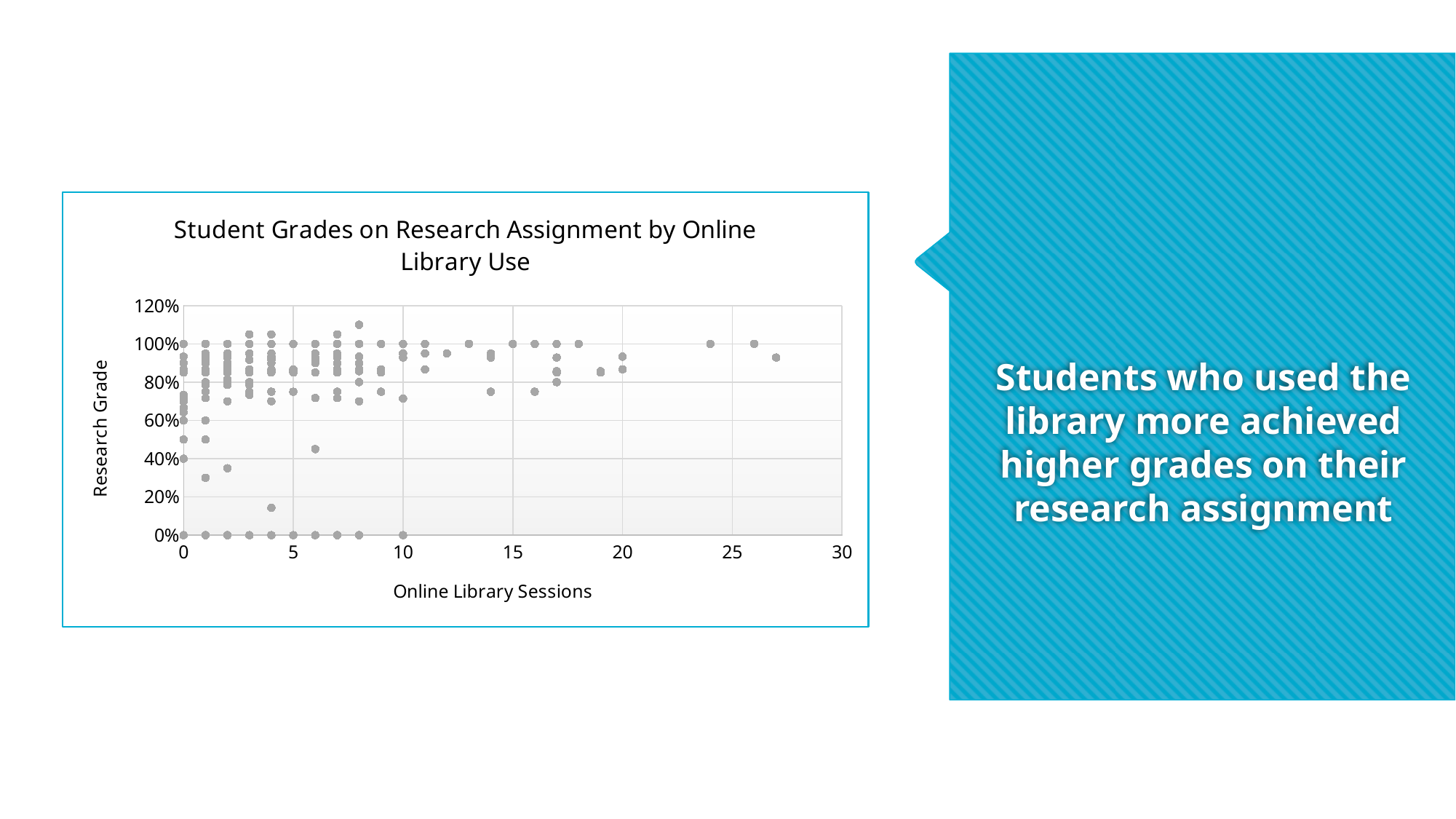
Do research grades generally rise or fall as the number of online library sessions increases? rise What kind of chart is shown on the slide? Scatter chart Is the lowest non-zero research grade, plotted at 4 online library sessions, greater or less than 40%? less Is the highest plotted research grade (at about 8 online library sessions) greater or less than 100%? greater Is the research grade for the student with 27 online library sessions greater or less than 80%? greater What is the label on the vertical axis of the chart? Research Grade What is the title of the chart? Student Grades on Research Assignment by Online Library Use